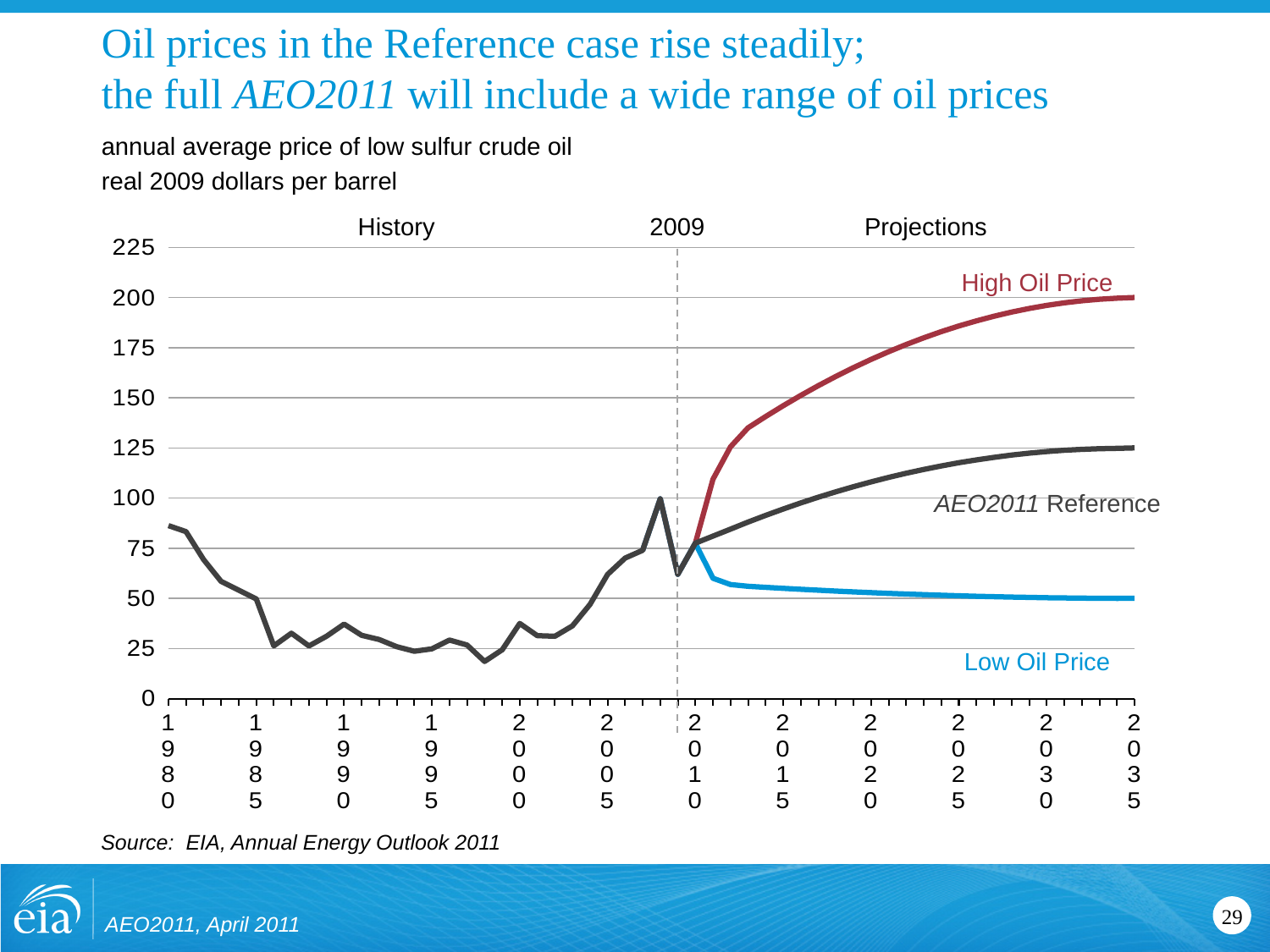
Is the High Oil Price value in 2035 greater or less than 175? greater In 2035, which is higher: the High Oil Price line or the Low Oil Price line? High Oil Price Does the AEO2011 Reference line rise or fall from 2009 to 2035? rise What kind of chart is shown on the slide? line chart Is the AEO2011 Reference value in 2035 greater or less than 100? greater What year does the dashed vertical line separating History from Projections mark? 2009 Is the Low Oil Price value in 2035 greater or less than 75? less Which projection series is shown in red? High Oil Price How many projection series are labelled on the chart? 3 Does the Low Oil Price line rise or fall from 2009 to 2035? fall